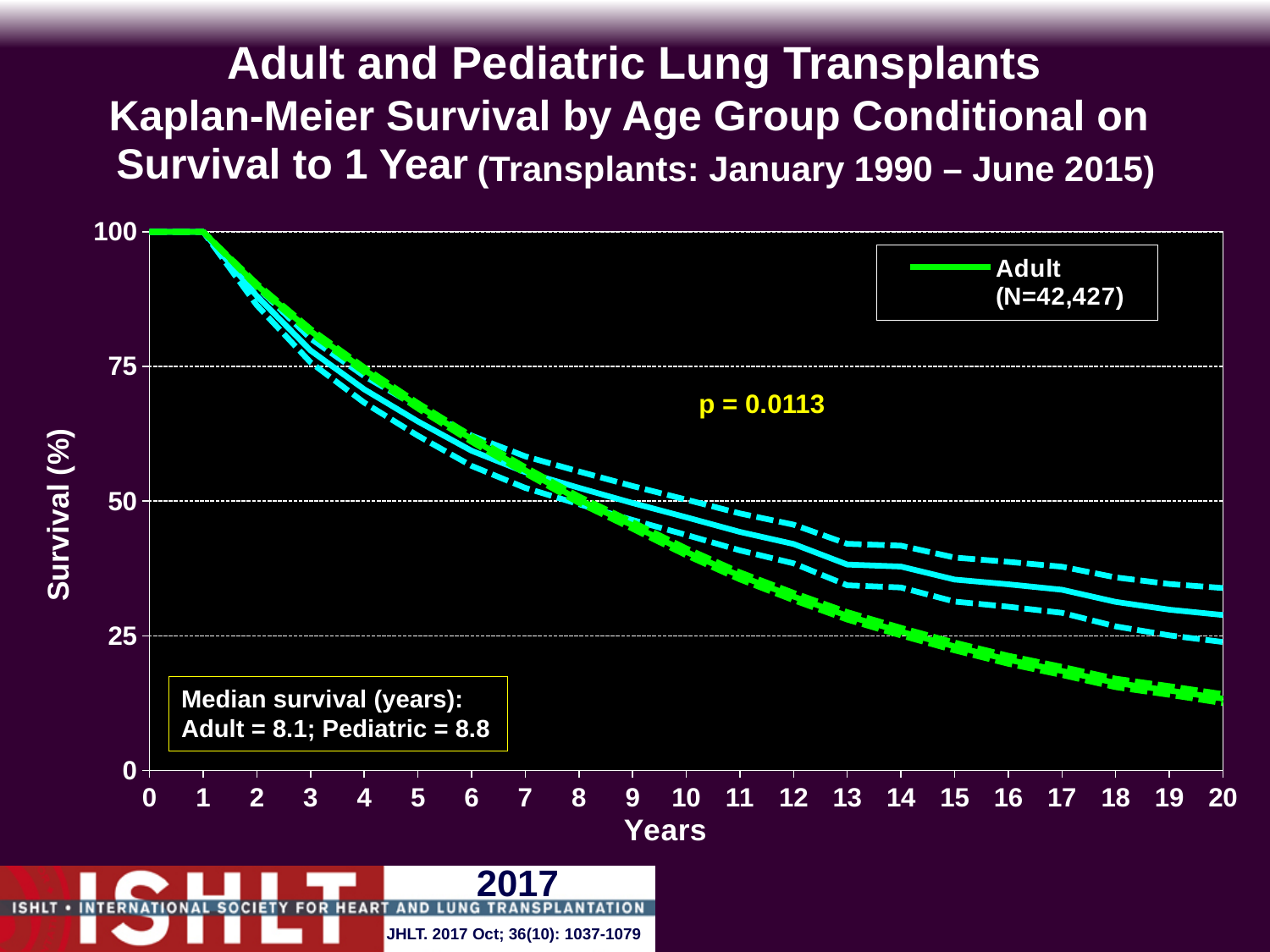
Which group has the longer median survival, Adult or Pediatric? Pediatric What is the median survival in years for the Pediatric group? 8.8 What is the median survival in years for the Adult group? 8.1 Is the Adult survival at 5 years greater or less than 50%? greater Is the Adult survival at 20 years greater or less than 25%? less What is the label of the x-axis? Years What kind of chart is shown on the slide? line chart What is the difference in median survival (years) between the Pediatric and Adult groups? 0.7 What is the N for the Adult group shown in the legend? 42,427 Does survival rise or fall as the years increase? fall What is the label of the y-axis? Survival (%) What p-value is printed on the chart? p = 0.0113